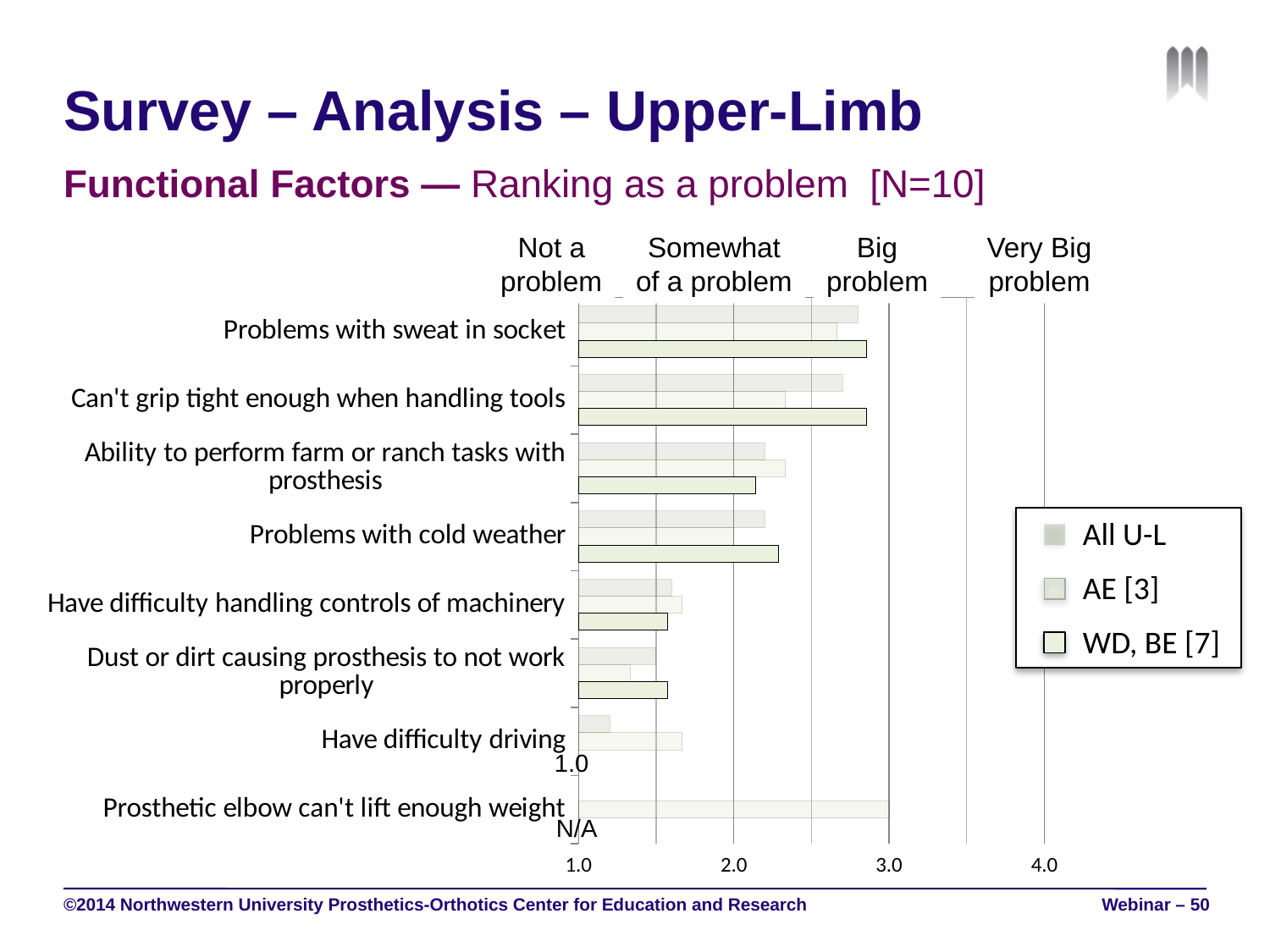
What are the three series names listed in the legend? All U-L, AE [3], WD, BE [7] What kind of chart is shown on the slide? bar chart How many series does the legend list? 3 How many functional factor categories are listed on the chart? 8 Is the All U-L value for 'Have difficulty driving' greater or less than 2.0? less Is the AE [3] value for 'Have difficulty handling controls of machinery' greater or less than 2.0? less What is the WD, BE [7] value printed for 'Have difficulty driving'? 1.0 What is printed for the WD, BE [7] value of 'Prosthetic elbow can't lift enough weight'? N/A What label on the x axis corresponds to the value 4.0? Very Big problem Is the WD, BE [7] value for 'Problems with sweat in socket' greater or less than 2.0? greater Which has the larger All U-L value: 'Problems with sweat in socket' or 'Have difficulty driving'? Problems with sweat in socket Which has the larger WD, BE [7] value: 'Problems with cold weather' or 'Dust or dirt causing prosthesis to not work properly'? Problems with cold weather